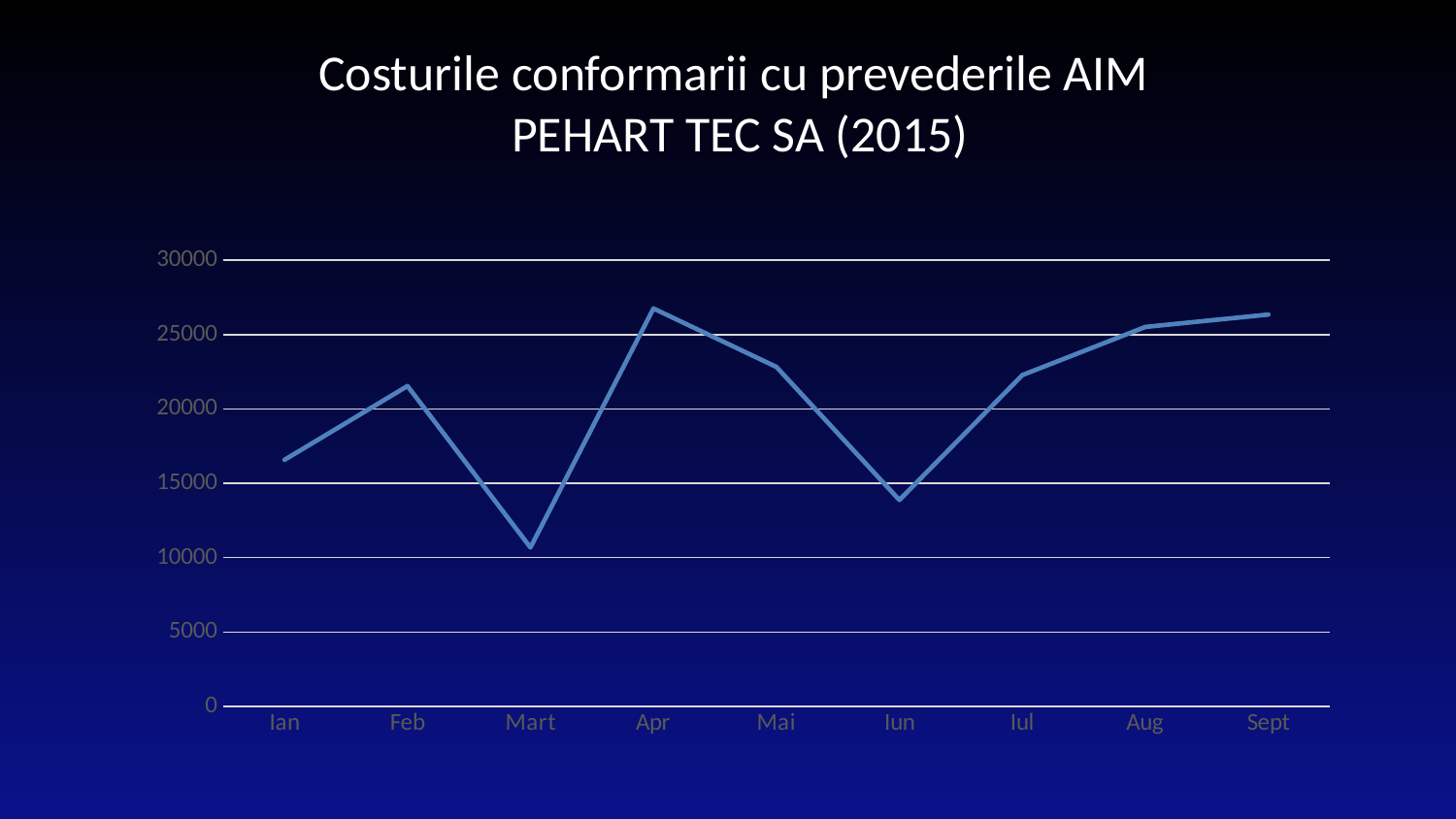
Is the value for Mart greater or less than 15000? less Which month has the lowest value? Mart Do the values rise or fall from Iun to Sept? rise Which is larger, the value for Apr or the value for Iun? Apr Is the value for Ian greater or less than 20000? less Is the value for Iun greater or less than 15000? less What kind of chart is shown on the slide? line chart How many months are plotted on the x axis? 9 Which is larger, the value for Feb or the value for Mart? Feb What is the title of the chart? Costurile conformarii cu prevederile AIM PEHART TEC SA (2015)